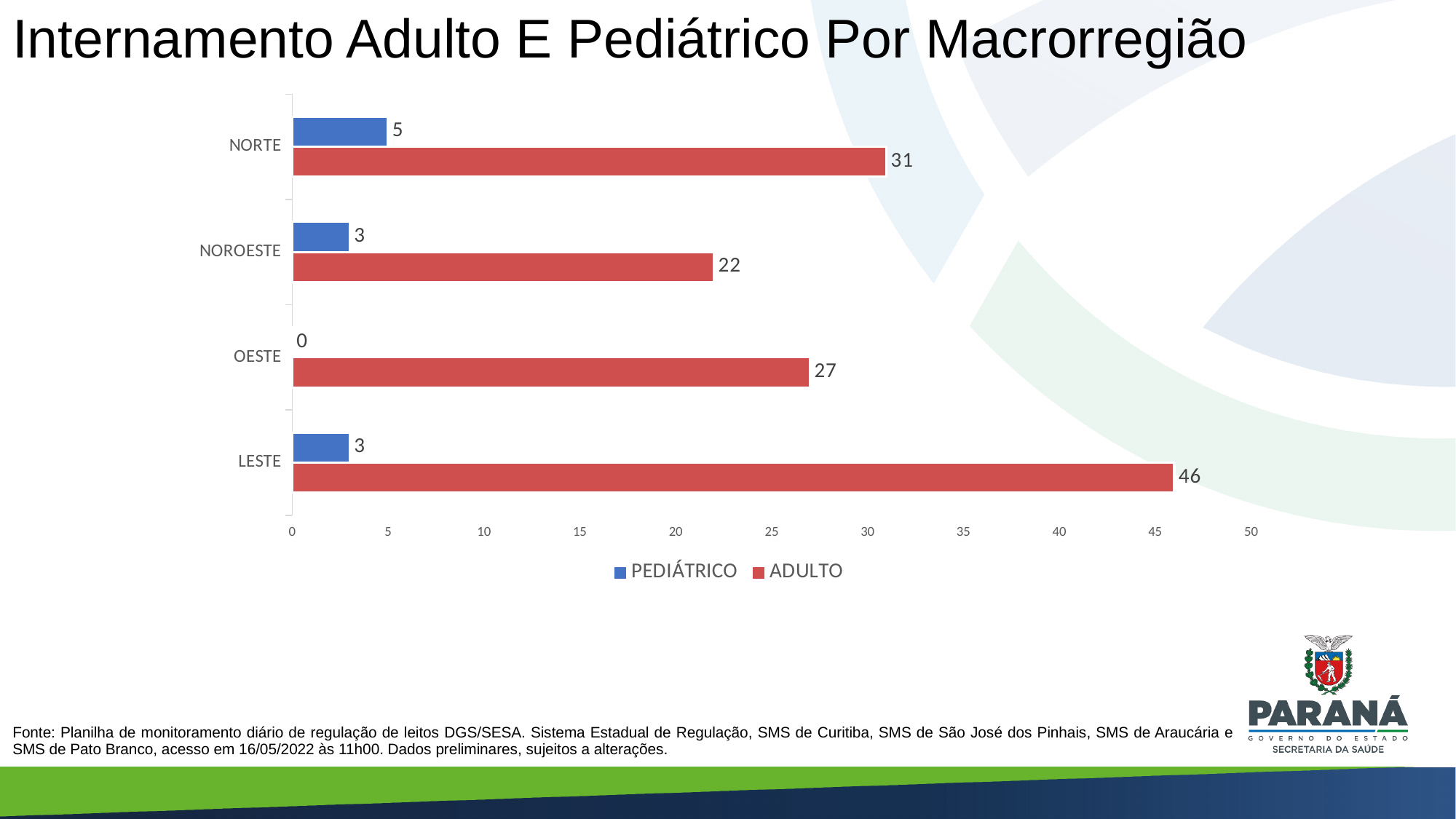
What colour are the ADULTO bars? Red Which macrorregião has the lowest PEDIÁTRICO value? OESTE Which is larger, the ADULTO value for OESTE or for NOROESTE? OESTE How many macrorregiões are shown on the chart? 4 How many series does the legend list? 2 What is the PEDIÁTRICO value for OESTE? 0 What is the ADULTO value for LESTE? 46 What is the ADULTO value for NOROESTE? 22 What is the PEDIÁTRICO value for NORTE? 5 What kind of chart is shown on the slide? Bar chart Which macrorregião has the highest ADULTO value? LESTE What is the difference between the ADULTO values for LESTE and NORTE? 15